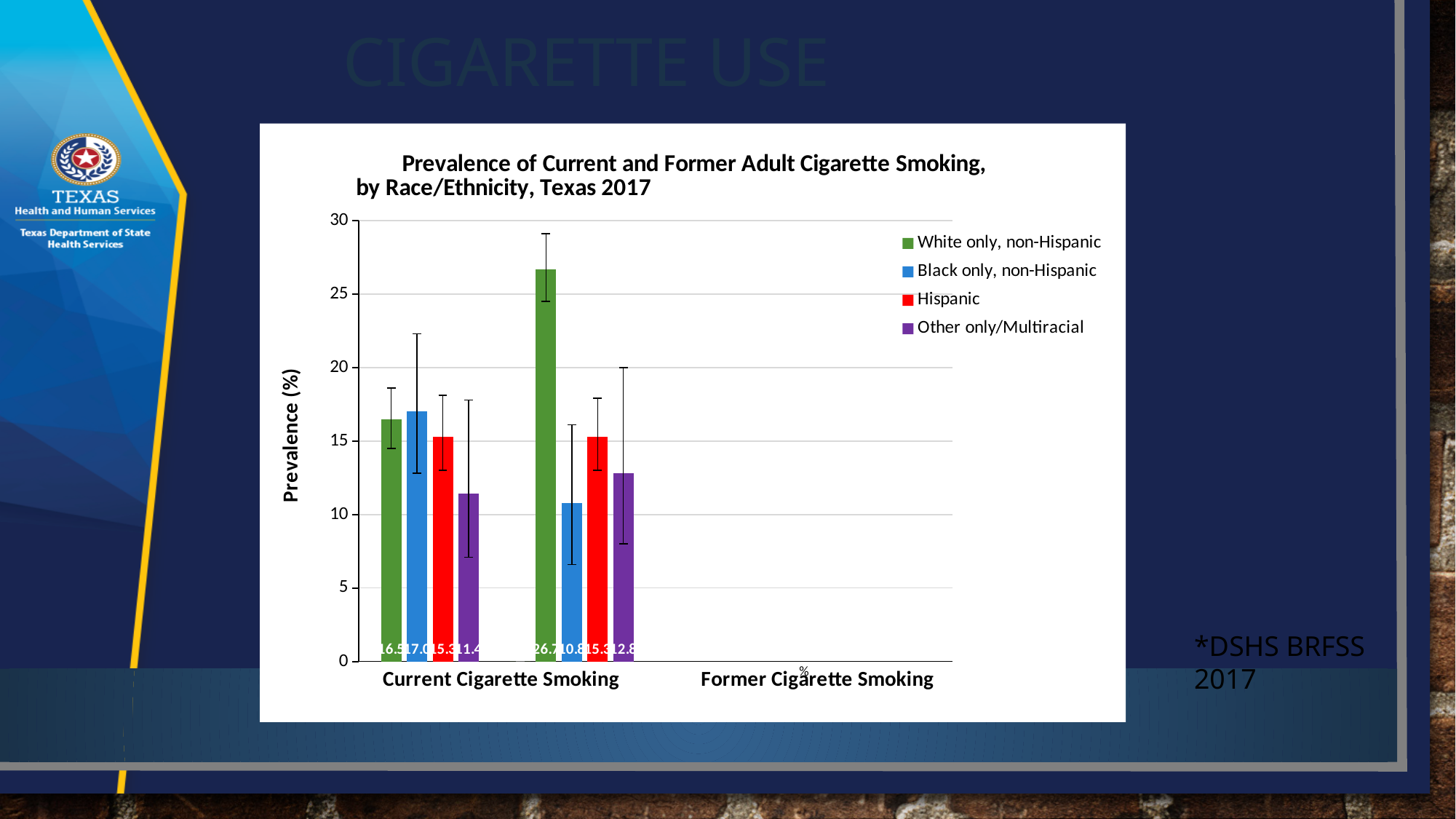
What is the title of the y axis? Prevalence (%) What is the difference between the Former Cigarette Smoking prevalence for White only, non-Hispanic and Black only, non-Hispanic adults? 15.9 Which race/ethnicity group has the highest prevalence of Former Cigarette Smoking? White only, non-Hispanic For Black only, non-Hispanic adults, is the prevalence higher for Current Cigarette Smoking or Former Cigarette Smoking? Current Cigarette Smoking What kind of chart is shown on the slide? bar chart What is the prevalence of Former Cigarette Smoking for Hispanic adults? 15.3 What is the prevalence of Current Cigarette Smoking for Black only, non-Hispanic adults? 17.0 Is the Former Cigarette Smoking value for White only, non-Hispanic adults greater or less than 25? greater What is the prevalence of Former Cigarette Smoking for White only, non-Hispanic adults? 26.7 How many categories are shown on the x axis? 2 Which race/ethnicity group has the lowest prevalence of Current Cigarette Smoking? Other only/Multiracial How many series does the legend list? 4